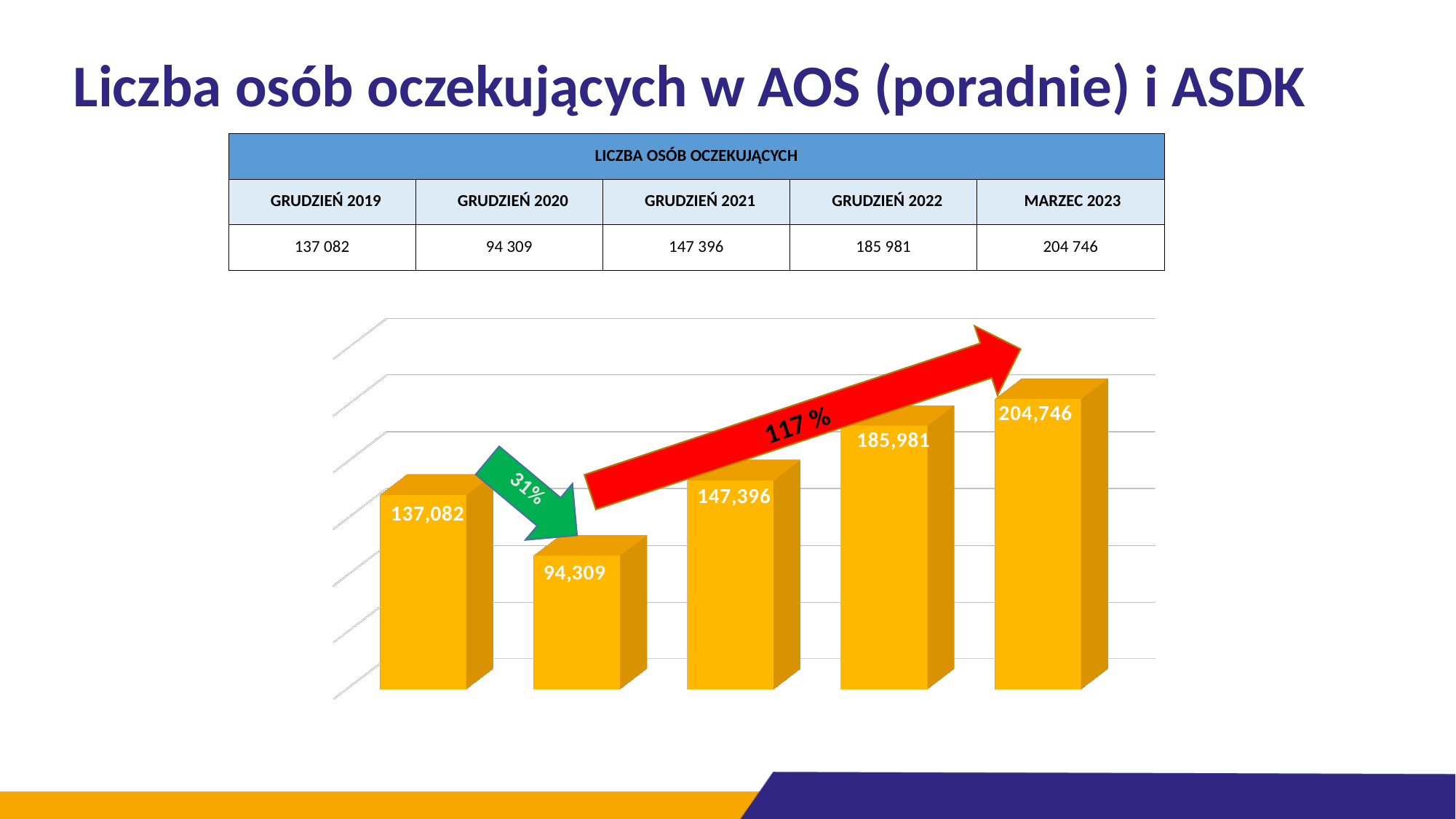
Which bar in the chart has the lowest value? The second bar (94,309) What is the difference between the rightmost bar (204,746) and the leftmost bar (137,082)? 67,664 How many bars are plotted in the chart? 5 What value is shown on the second bar of the chart? 94,309 Which is larger: the value of the first bar or the value of the third bar? The third bar (147,396) What value is shown on the rightmost bar of the chart? 204,746 What percentage is written on the red arrow in the chart? 117 % What type of chart is shown on the slide? Bar chart According to the table, how many people were waiting in Grudzień 2022? 185 981 What is the difference between the third bar (147,396) and the second bar (94,309)? 53,087 Which bar in the chart has the highest value? The rightmost bar (204,746) What value is shown on the first (leftmost) bar of the chart? 137,082